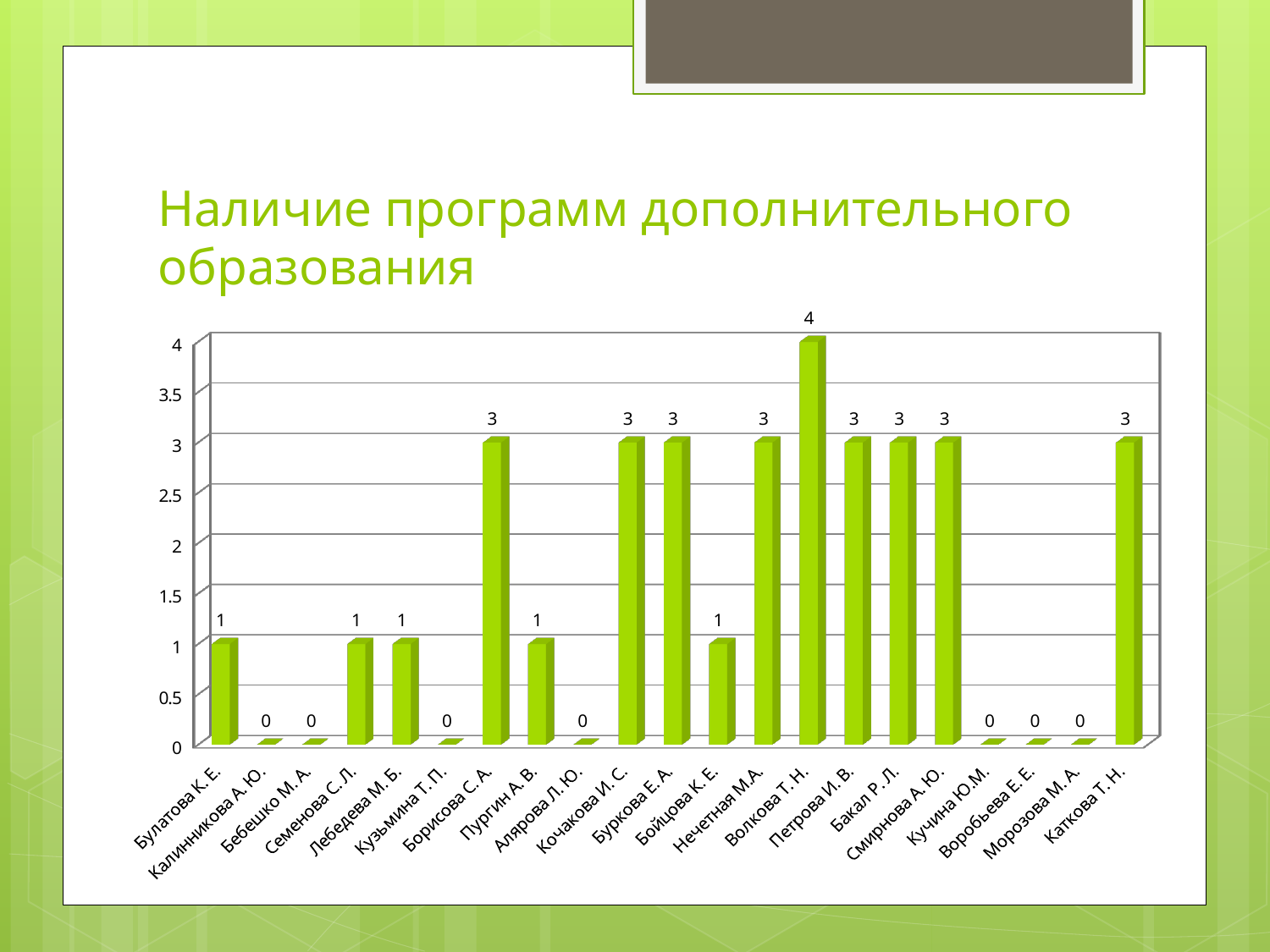
What kind of chart is shown on the slide? bar chart What is the value for Пургин А. В.? 1 Which category has the highest value? Волкова Т. Н. What is the value for Кучина Ю.М.? 0 Is the value for Смирнова А. Ю. greater or less than 2? greater What is the title of the slide? Наличие программ дополнительного образования What is the difference between the values for Волкова Т. Н. and Бойцова К. Е.? 3 How many categories have a value of 0? 7 Which is larger, the value for Каткова Т. Н. or the value for Лебедева М. Б.? Каткова Т. Н. How many categories are shown on the x axis? 21 What is the value for Волкова Т. Н.? 4 What is the value for Борисова С. А.? 3